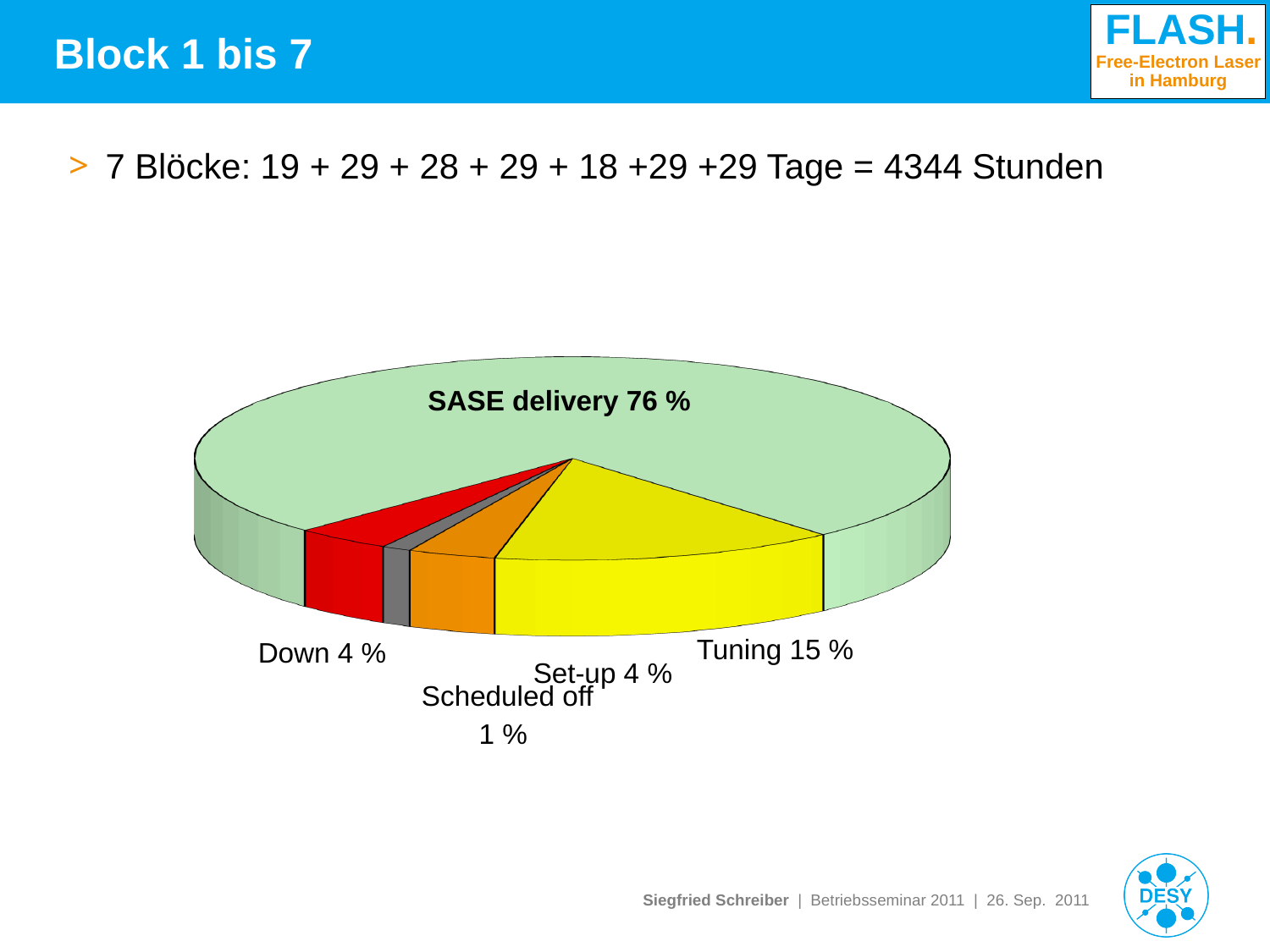
How many slices does the pie chart have? 5 What colour is the Tuning slice? Yellow What percentage is shown for Scheduled off? 1 % What is the difference in percentage points between SASE delivery and Tuning? 61 % What percentage is shown for Down? 4 % Which is larger, Tuning or Down? Tuning Which slice of the pie is the largest? SASE delivery What kind of chart is shown on the slide? Pie chart Which slice of the pie is the smallest? Scheduled off What percentage is shown for Tuning? 15 % What percentage is shown for Set-up? 4 % What share of the pie is SASE delivery? 76 %